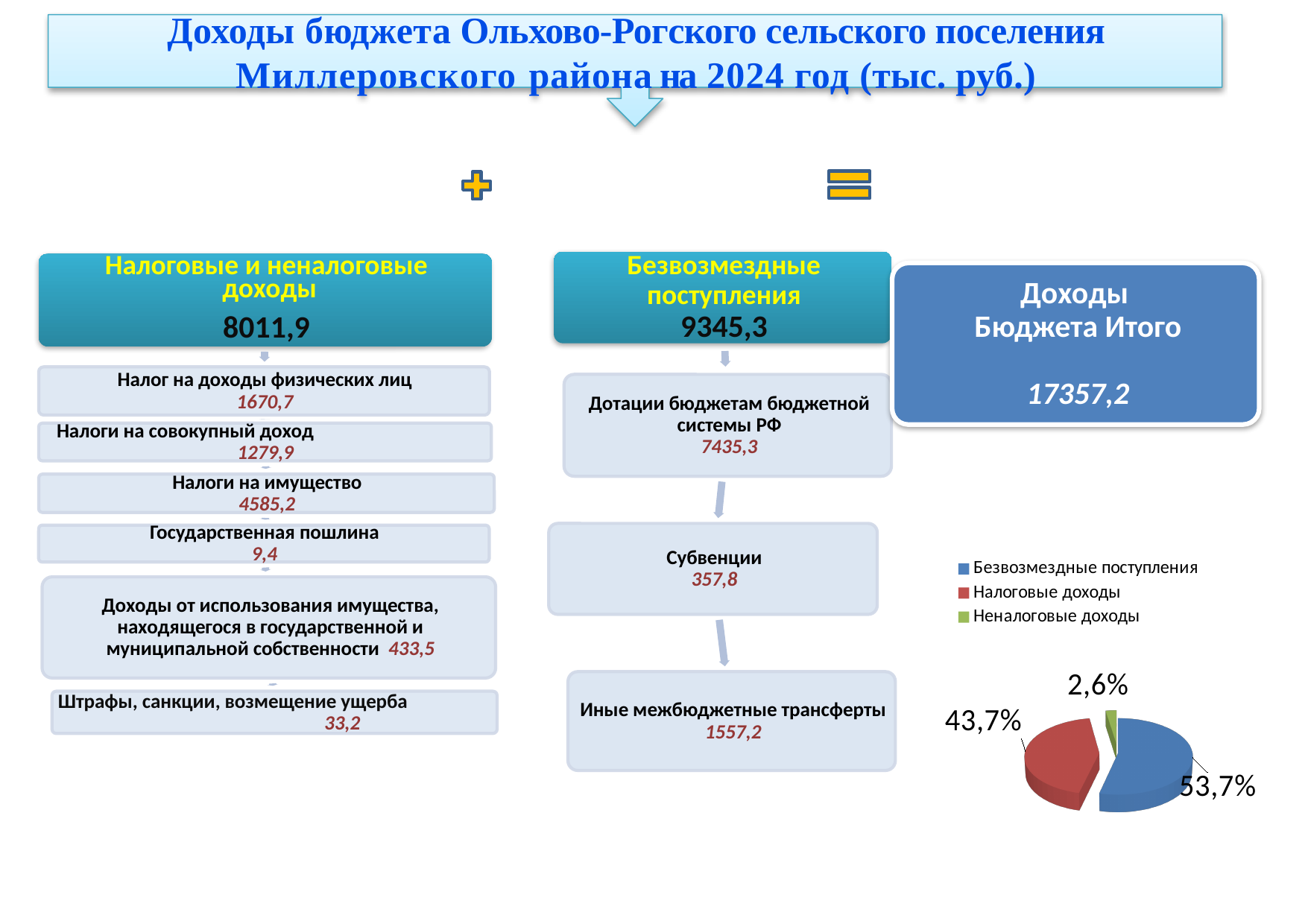
What kind of chart is shown at the bottom right of the slide? pie chart What share of the pie chart is Безвозмездные поступления? 53,7% What is the difference in percentage points between the Безвозмездные поступления slice and the Налоговые доходы slice in the pie chart? 10 percentage points What share of the pie chart is Налоговые доходы? 43,7% Which slice of the pie chart is the largest? Безвозмездные поступления In the pie chart, which is larger: Налоговые доходы or Неналоговые доходы? Налоговые доходы How many slices does the pie chart have? 3 What colour is the Налоговые доходы slice in the pie chart? red Which slice of the pie chart is the smallest? Неналоговые доходы How many entries does the pie chart legend list? 3 Which legend entry in the pie chart is shown in green? Неналоговые доходы What share of the pie chart is Неналоговые доходы? 2,6%